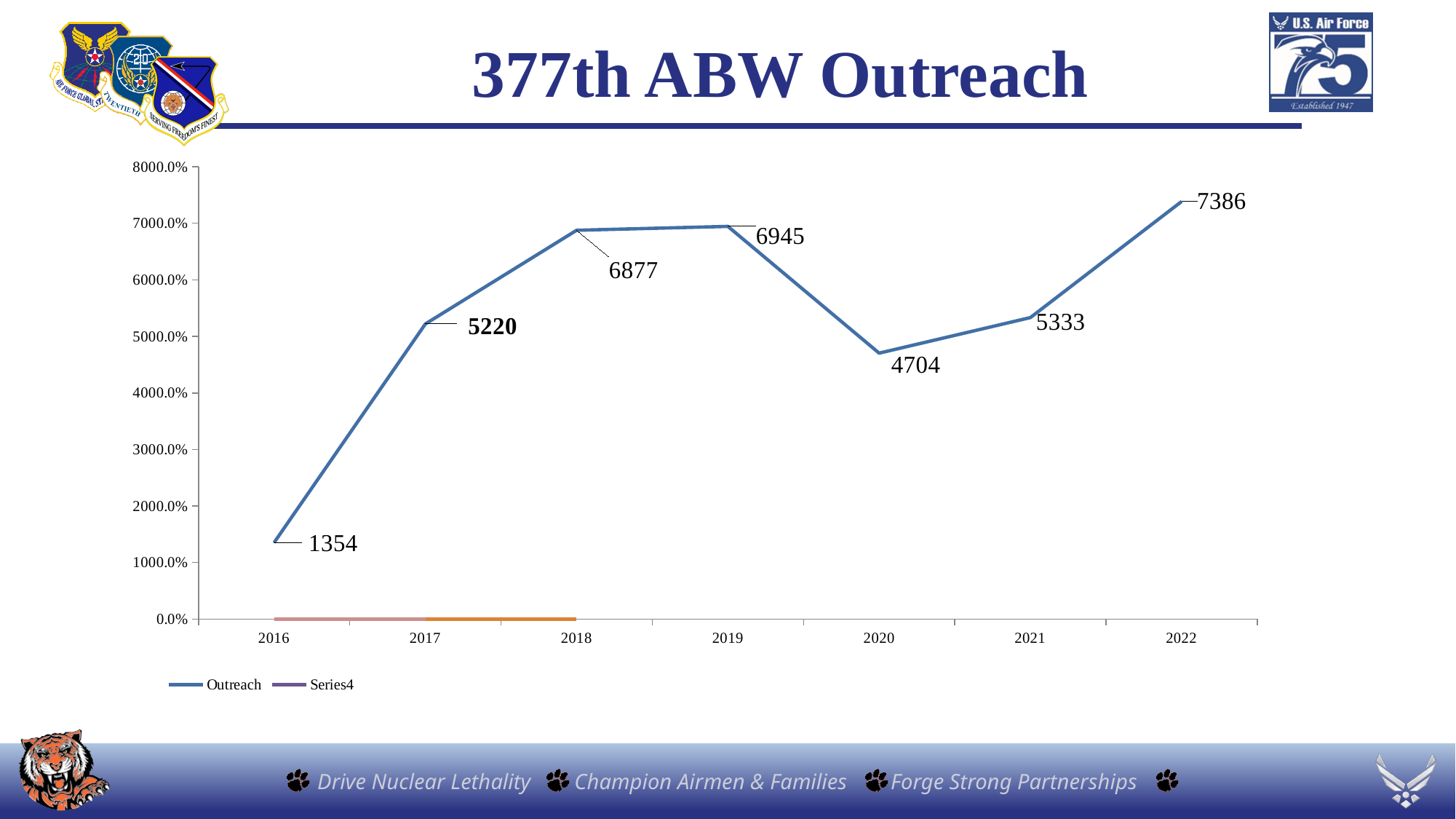
What is the Outreach value for 2020? 4704 What is the Outreach value for 2016? 1354 Which year has a larger Outreach value, 2017 or 2021? 2021 What type of chart is shown on the slide? line chart What is the difference between the Outreach values for 2019 and 2020? 2241 How many years are plotted on the x axis? 7 Which year has the highest Outreach value? 2022 What is the Outreach value for 2022? 7386 Does the Outreach value rise or fall from 2019 to 2020? fall What is the difference between the Outreach values for 2022 and 2021? 2053 Which year has the lowest Outreach value? 2016 How many series does the legend list? 2